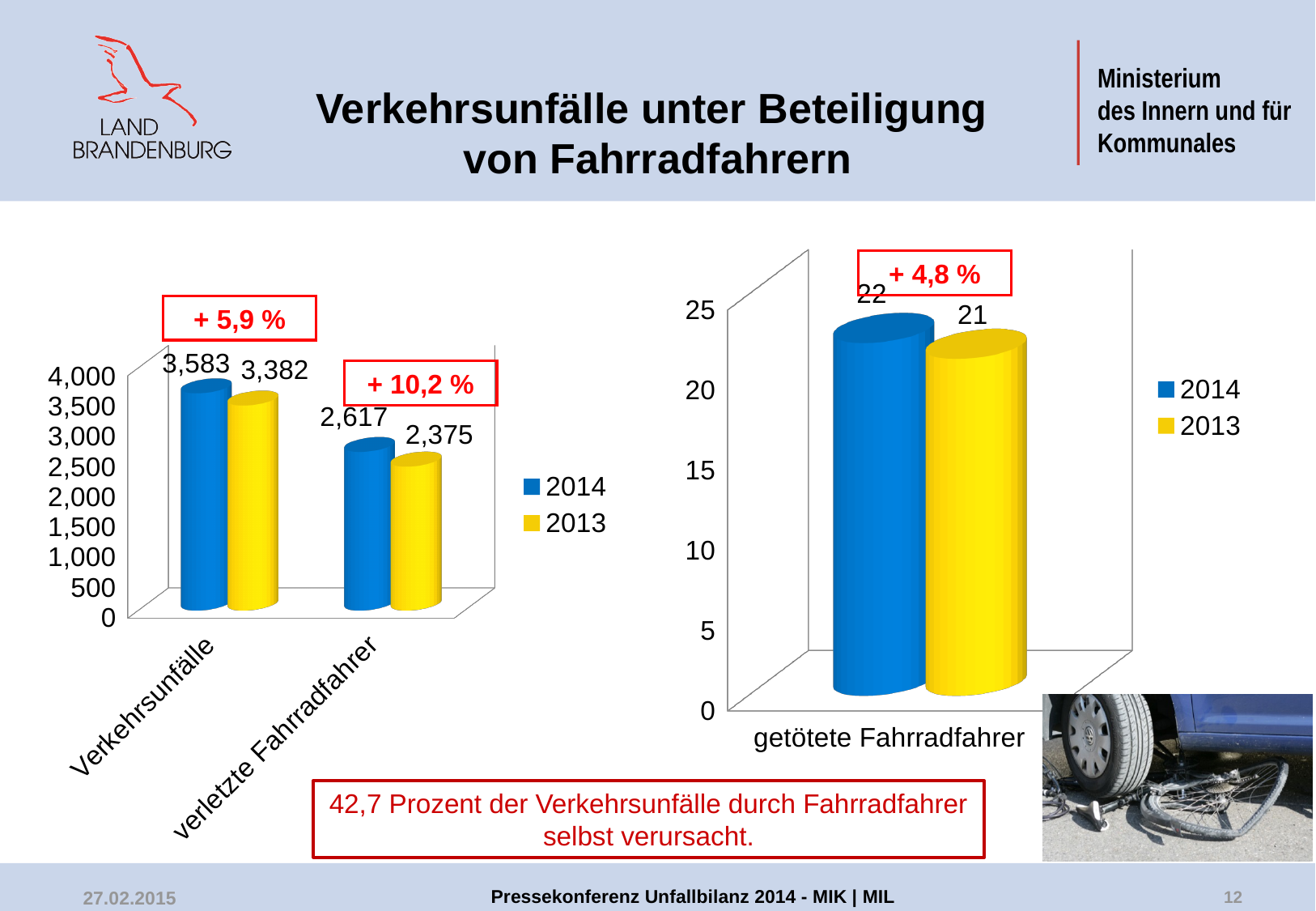
In the left chart, what is the 2014 value for Verkehrsunfälle? 3,583 How many series does the legend of the right chart list? 2 In the left chart, which category has the highest 2014 value? Verkehrsunfälle In the right chart, what is the 2014 value for getötete Fahrradfahrer? 22 In the right chart, what percentage change is shown in the red box above the bars? + 4,8 % What kind of chart is the right chart? bar chart In the left chart, what is the difference between the 2014 and 2013 values for Verkehrsunfälle? 201 How many categories are shown on the x axis of the left chart? 2 In the right chart, what is the 2013 value for getötete Fahrradfahrer? 21 In the left chart, what is the difference between the 2014 and 2013 values for verletzte Fahrradfahrer? 242 In the left chart, what is the 2013 value for verletzte Fahrradfahrer? 2,375 In the left chart, which is larger for verletzte Fahrradfahrer, the 2014 value or the 2013 value? 2014